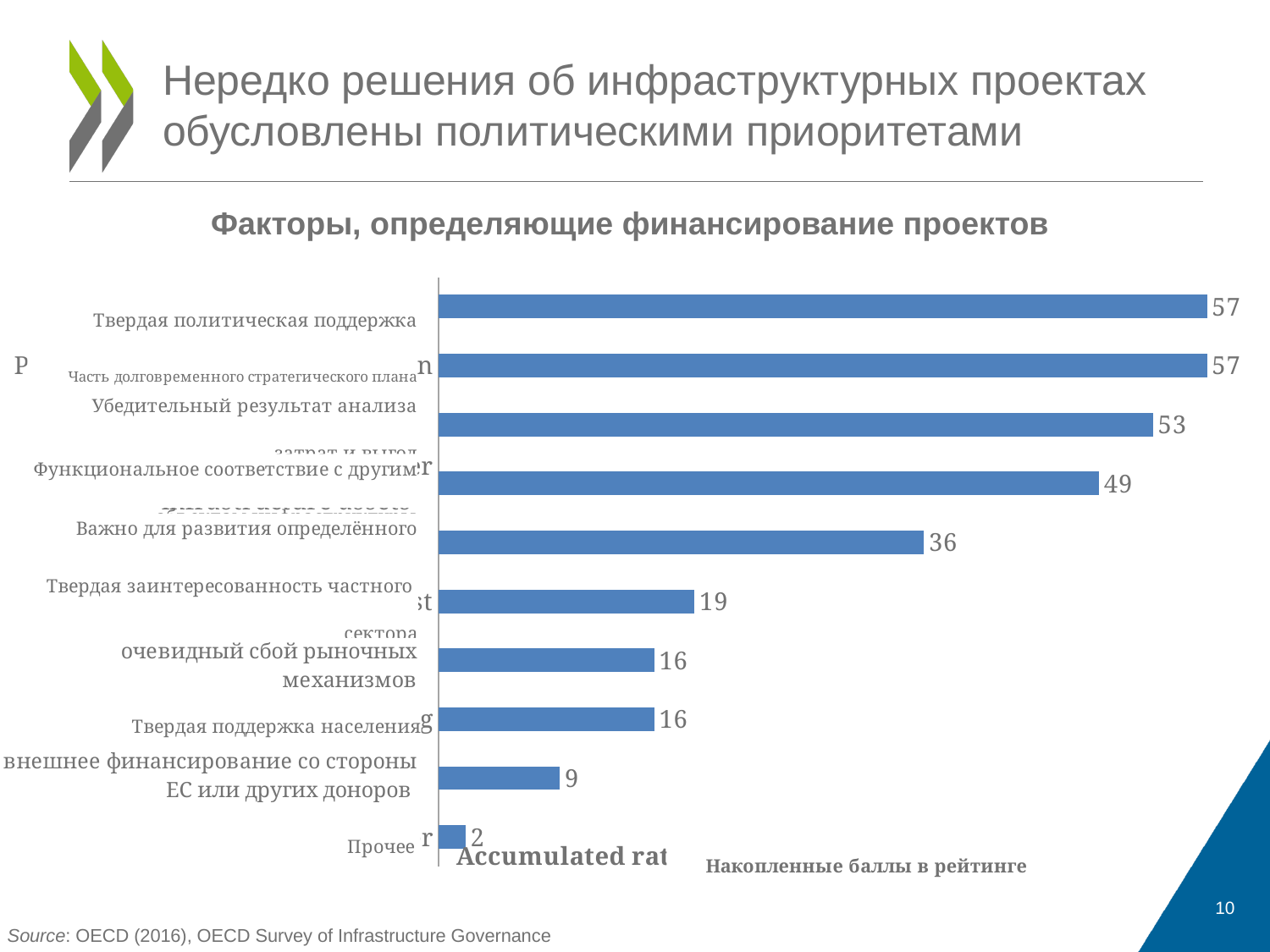
How many bars does the chart show? 10 What is the value for "очевидный сбой рыночных механизмов"? 16 Which is larger: the value for "Твердая политическая поддержка" or the value for "Твердая поддержка населения"? Твердая политическая поддержка What is the title of the chart? Факторы, определяющие финансирование проектов What is the value for "Прочее"? 2 What is the difference between the value for "Твердая политическая поддержка" and the value for "Прочее"? 55 What is the value for "Твердая политическая поддержка"? 57 What is the value for "Твердая поддержка населения"? 16 What is the value for "внешнее финансирование со стороны ЕС или других доноров"? 9 What is the difference between the value for "Твердая поддержка населения" and the value for "внешнее финансирование со стороны ЕС или других доноров"? 7 Which category has the lowest value? Прочее What kind of chart is shown on the slide? Bar chart